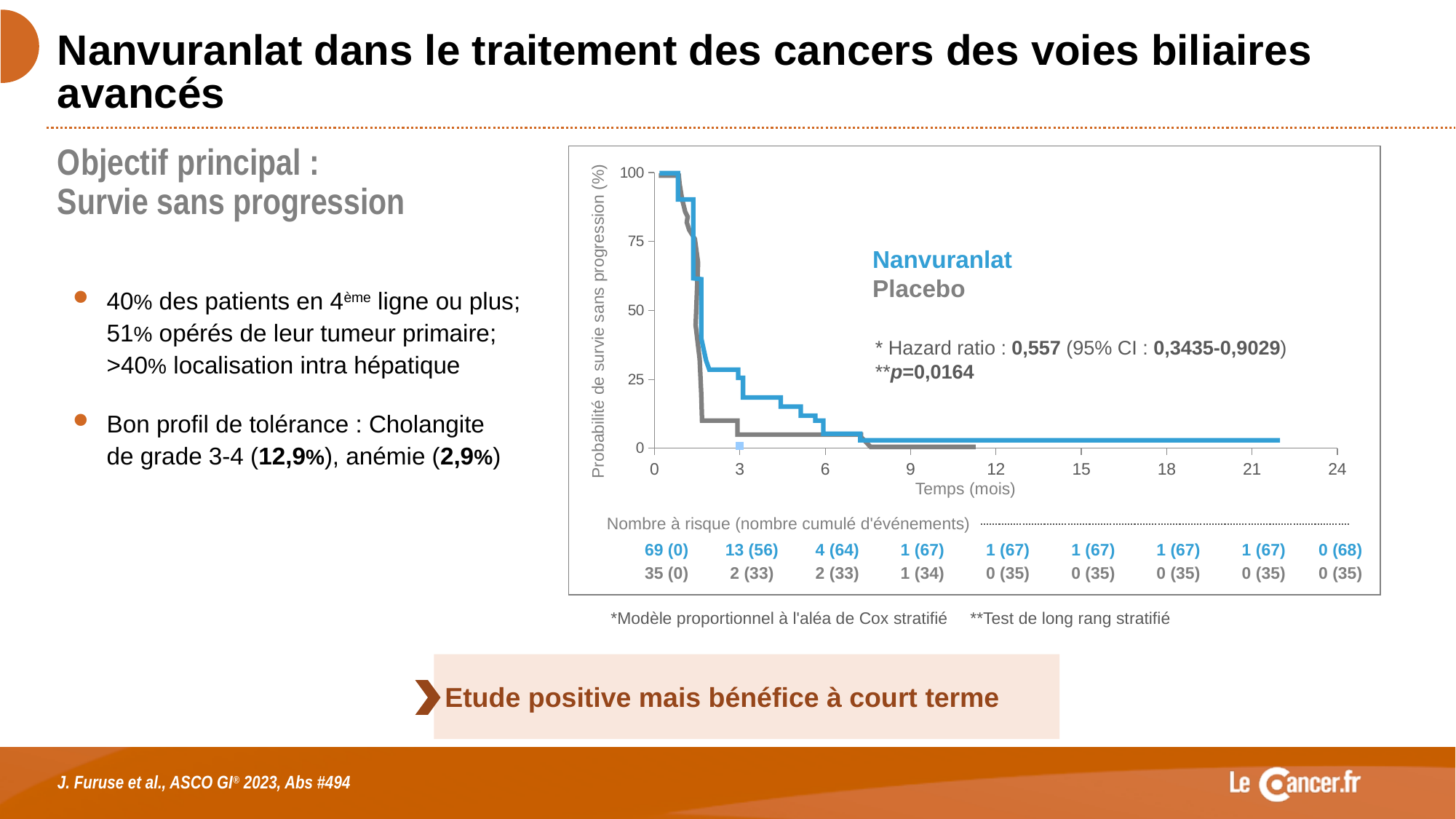
What hazard ratio is printed on the chart? 0,557 At 3 months, which group has more patients at risk, Nanvuranlat or Placebo? Nanvuranlat In the number-at-risk table, what is the entry for Placebo at 3 months? 2 (33) What are the two series named in the chart's legend? Nanvuranlat and Placebo How many series does the chart's legend list? 2 Is the Nanvuranlat progression-free survival probability at 6 months greater or less than 25? less What is the difference between the number of Nanvuranlat and Placebo patients at risk at time 0? 34 What kind of chart is shown on the slide? line chart Do the survival curves rise or fall as time increases along the x axis? fall In the number-at-risk table, how many Nanvuranlat patients were at risk at time 0? 69 In the number-at-risk table, how many Placebo patients were at risk at time 0? 35 In the number-at-risk table, what is the entry for Nanvuranlat at 3 months? 13 (56)